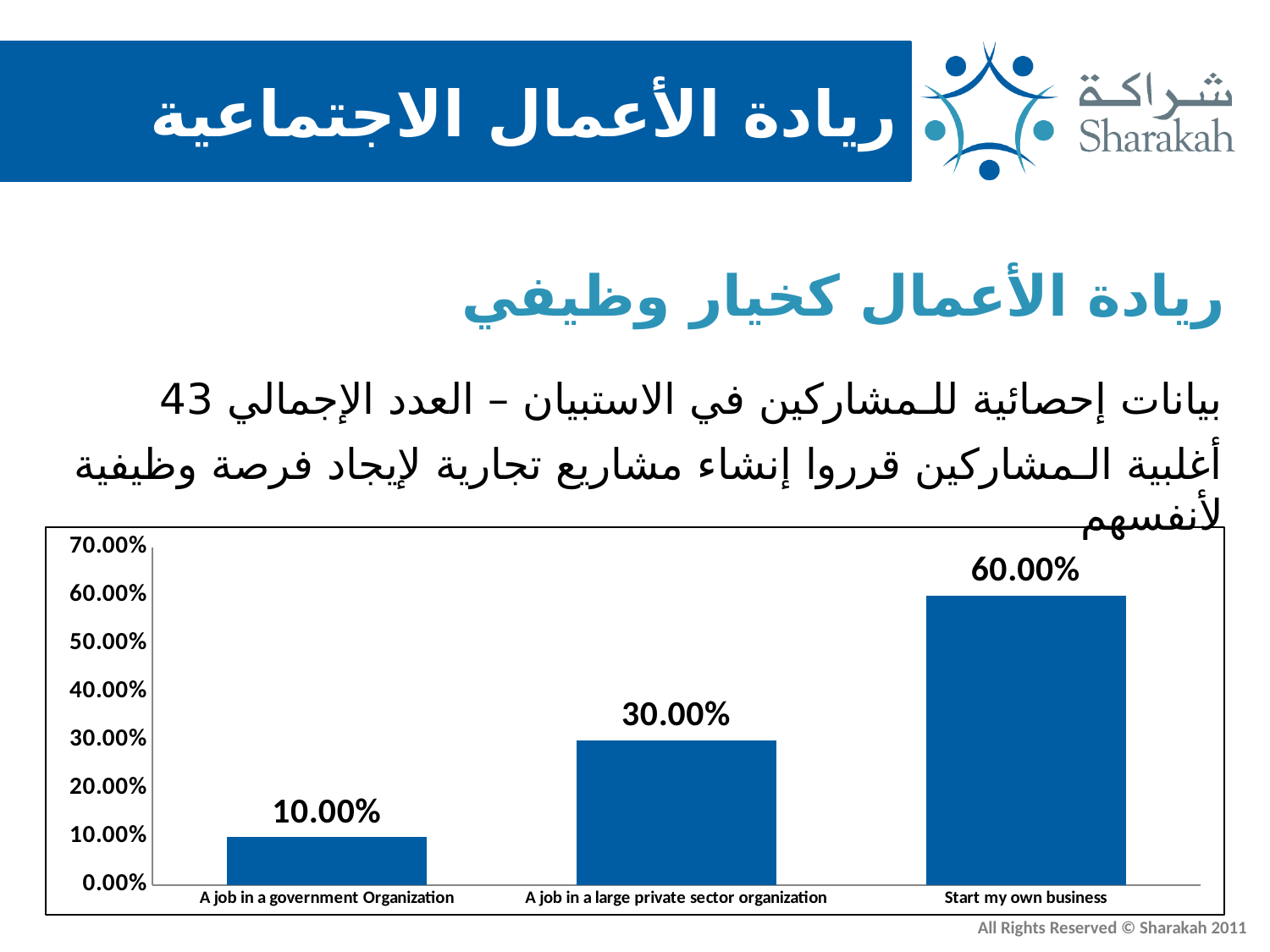
What is the difference between the values for "Start my own business" and "A job in a large private sector organization"? 30.00% Do the values rise or fall from left to right along the x axis? rise Is the value for "Start my own business" greater or less than 50.00%? greater What is the value for "Start my own business"? 60.00% Which category has the lowest value? A job in a government Organization What kind of chart is shown on the slide? bar chart What is the value for "A job in a large private sector organization"? 30.00% What is the difference between the values for "A job in a large private sector organization" and "A job in a government Organization"? 20.00% What is the value for "A job in a government Organization"? 10.00% How many categories are shown on the x axis? 3 Which category has the highest value? Start my own business Which is larger: the value for "A job in a large private sector organization" or "A job in a government Organization"? A job in a large private sector organization